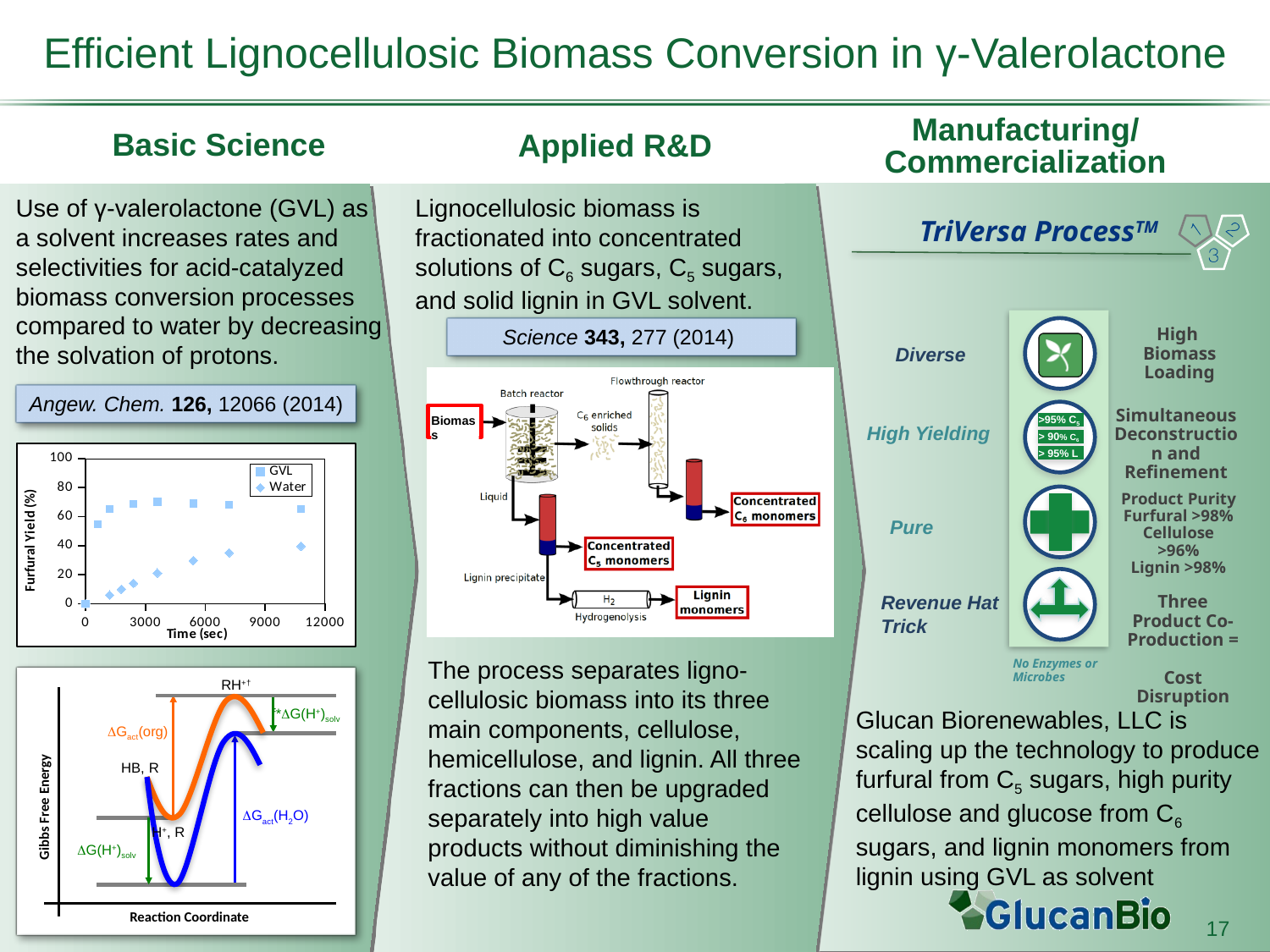
In the Furfural Yield chart, which series has the lowest furfural yield at around 6000 sec, GVL or Water? Water What is the label of the x axis of the Furfural Yield chart? Time (sec) What are the two series named in the legend of the Furfural Yield chart? GVL and Water In the Furfural Yield chart, is the GVL furfural yield at around 3000 sec greater or less than 60? greater In the Furfural Yield chart, is the Water furfural yield at around 3000 sec greater or less than 40? less What is the highest value shown on the y axis of the Furfural Yield chart? 100 What kind of chart is the Furfural Yield (%) versus Time (sec) chart on the slide? scatter chart In the Furfural Yield chart, which series reaches the higher furfural yield, GVL or Water? GVL How many series does the legend of the Furfural Yield chart list? 2 In the Furfural Yield chart, are all the Water series values greater or less than 60? less In the Furfural Yield chart, does the Water series rise or fall as time increases? rise